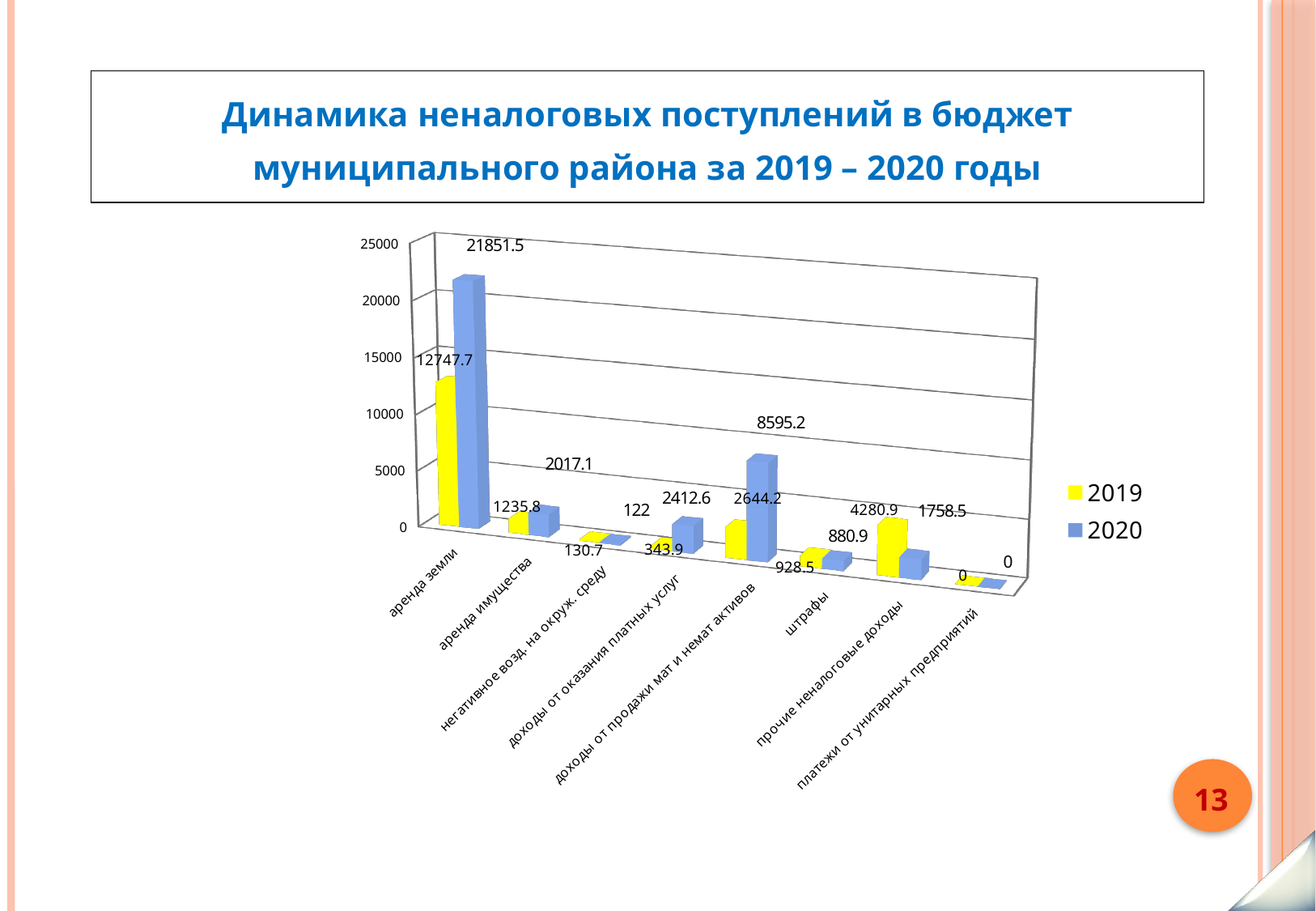
What type of chart is shown on the slide? Bar chart How many series does the legend list? 2 What is the difference between the 2020 and 2019 values for аренда земли? 9103.8 What is the 2020 value for доходы от продажи мат и немат активов? 8595.2 Which is larger for прочие неналоговые доходы: the 2019 value or the 2020 value? 2019 Which category has the highest 2020 value? аренда земли What is the 2019 value for аренда земли? 12747.7 Which colour represents the 2020 series in the legend? Blue What is the 2019 value for прочие неналоговые доходы? 4280.9 What is the 2020 value for аренда земли? 21851.5 Which category has the lowest 2019 value? платежи от унитарных предприятий How many categories are shown on the x axis? 8